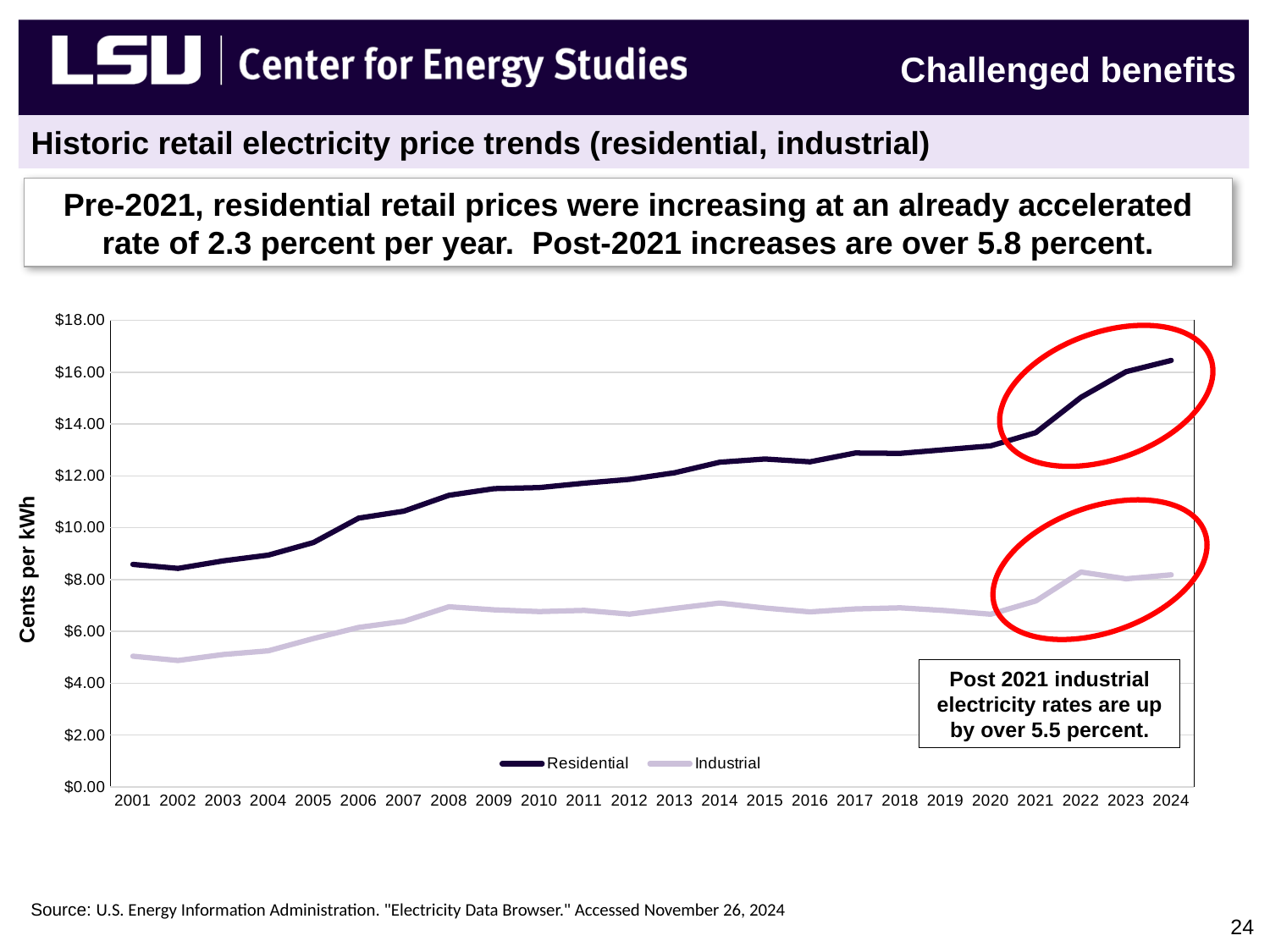
How many series does the chart's legend list? 2 Which series has the higher value in 2024, Residential or Industrial? Residential Which two series are listed in the chart's legend? Residential and Industrial What kind of chart is shown on the slide? Line chart Does the Residential line generally rise or fall from 2001 to 2024? Rise Is the Residential value for 2020 greater or less than $14.00? less Is the Residential value for 2024 greater or less than $16.00? greater What is the label on the vertical axis of the chart? Cents per kWh Is the Residential value for 2010 greater or less than $10.00? greater How many years are shown along the x axis of the chart? 24 In which year is the Residential value highest? 2024